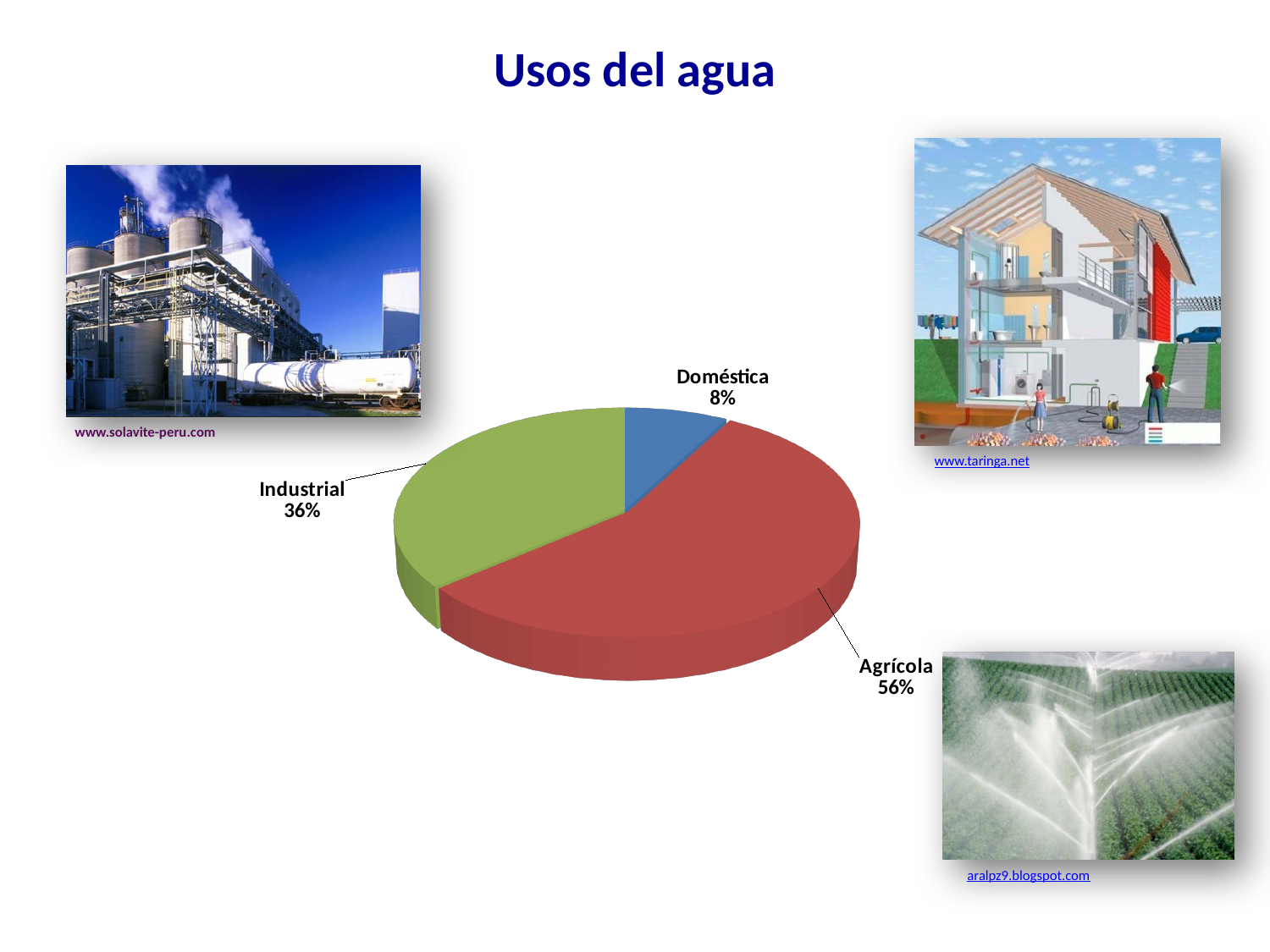
What is the difference in percentage points between the Agrícola and Industrial shares? 20 What is the difference in percentage points between the Industrial and Doméstica shares? 28 What is the title of the slide containing the chart? Usos del agua What share of water use does the Doméstica slice represent? 8% Which is larger, the Industrial share or the Doméstica share? Industrial Which category has the smallest share of the pie? Doméstica What kind of chart is shown on the slide? Pie chart What share of water use does the Agrícola slice represent? 56% How many categories are shown in the pie chart? 3 Which category has the largest share of the pie? Agrícola What share of water use does the Industrial slice represent? 36% What colour is the Agrícola slice of the pie? Red